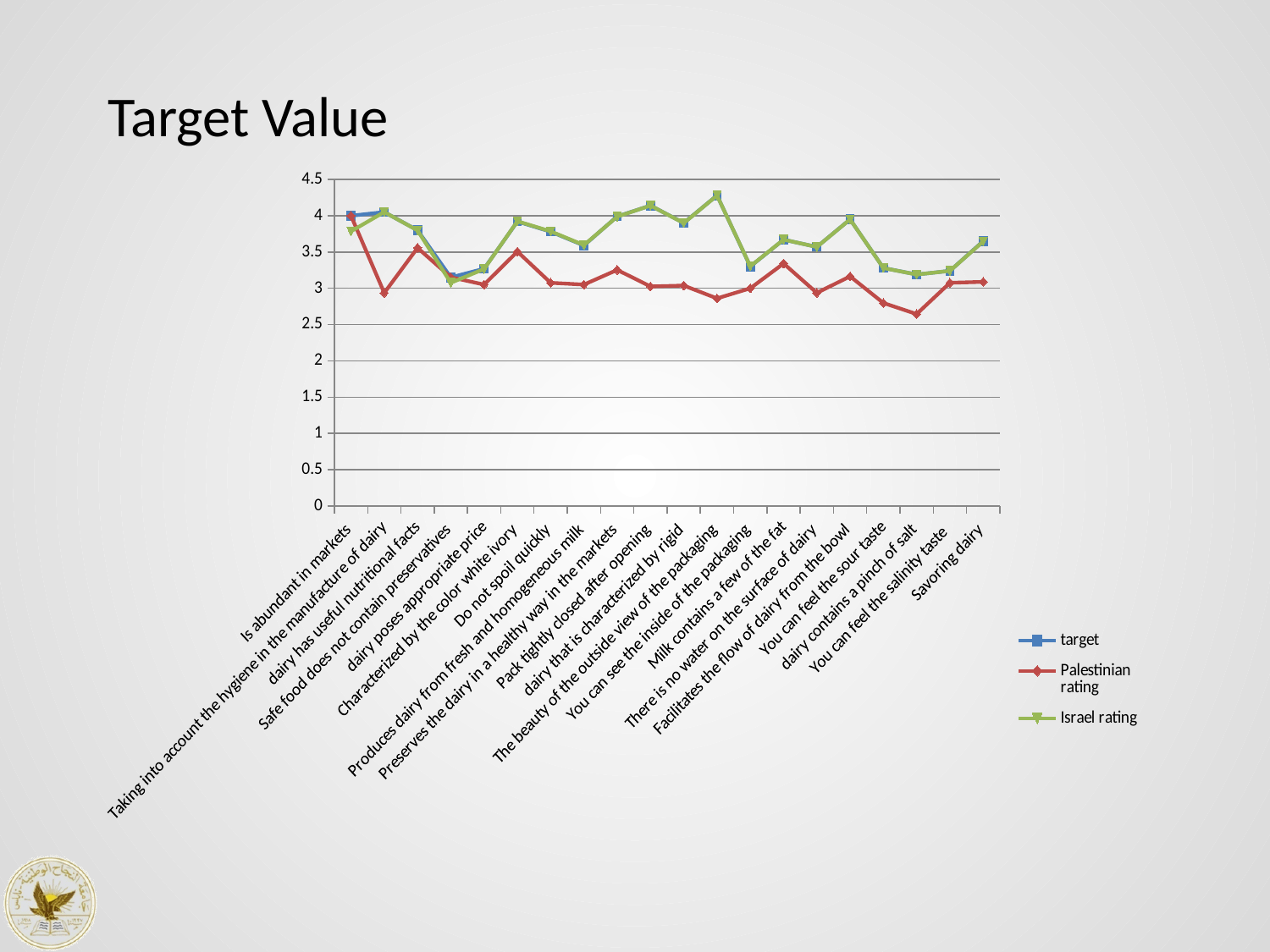
For 'You can feel the sour taste', which is higher: the Israel rating or the Palestinian rating? Israel rating Is the Palestinian rating for 'dairy contains a pinch of salt' greater or less than 3? less Is the Israel rating for 'The beauty of the outside view of the packaging' greater or less than 4? greater Which series are listed in the legend? target, Palestinian rating, Israel rating Is the Palestinian rating for 'Is abundant in markets' greater or less than 3.5? greater How many series does the legend list? 3 For which category is the Israel rating highest? The beauty of the outside view of the packaging How many categories are plotted along the x axis? 20 What is the title of the chart? Target Value What kind of chart is shown on the slide? line chart For which category is the Palestinian rating lowest? dairy contains a pinch of salt